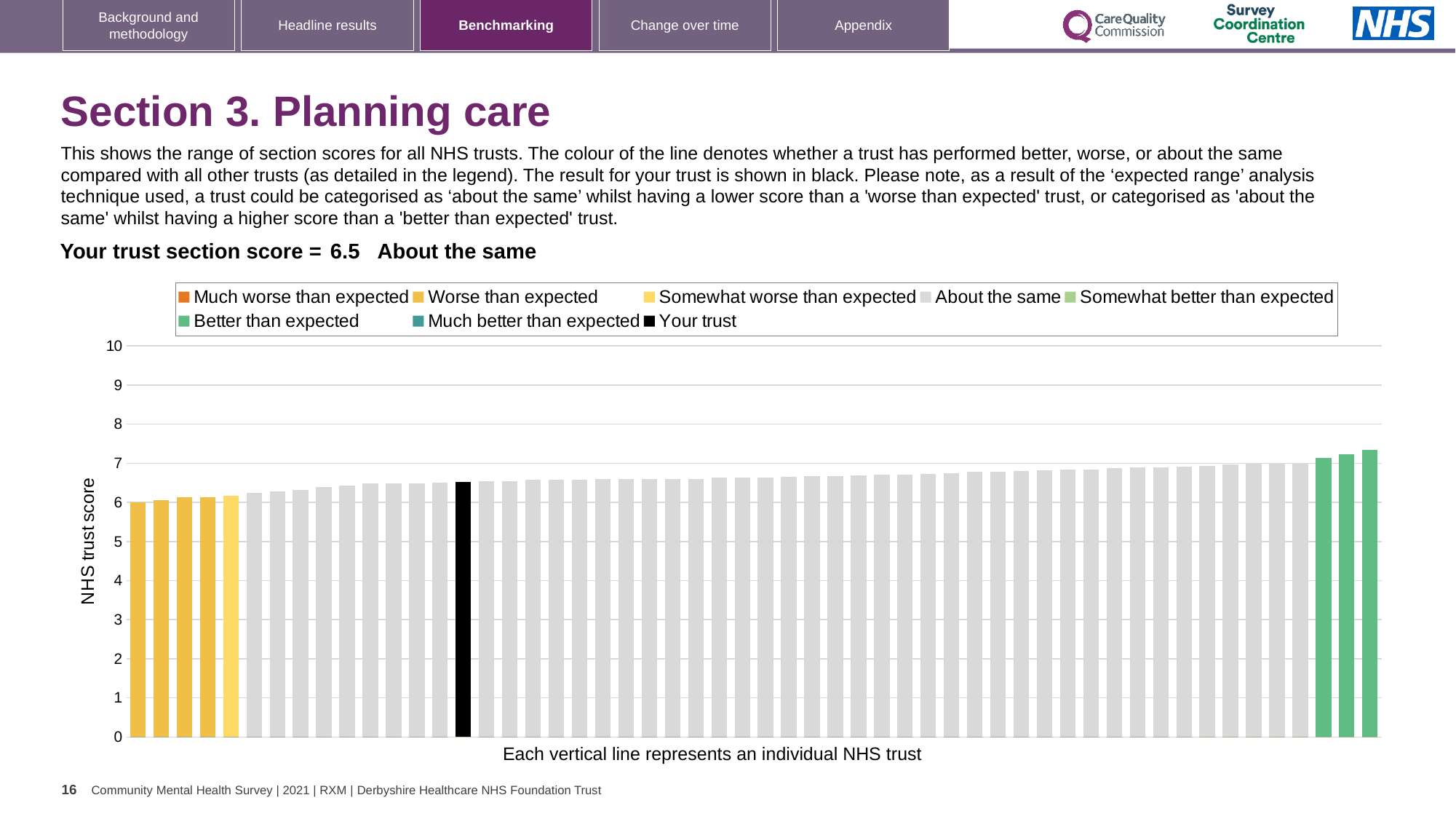
How many entries does the chart legend list? 8 Is the value for your trust (the black bar) greater or less than 7? less Is the value of the lowest bar in the chart greater or less than 5? greater What category is your trust placed in according to the text above the chart? About the same What is the section score for your trust shown on the slide? 6.5 Is the value for your trust (the black bar) greater or less than 6? greater What is the label on the vertical axis of the chart? NHS trust score Do the bar values rise or fall from left to right along the x axis? rise What kind of chart is shown on the slide? bar chart How many bars are coloured in the darker yellow 'Worse than expected' colour? 4 How many bars are coloured green (better than expected) in the chart? 3